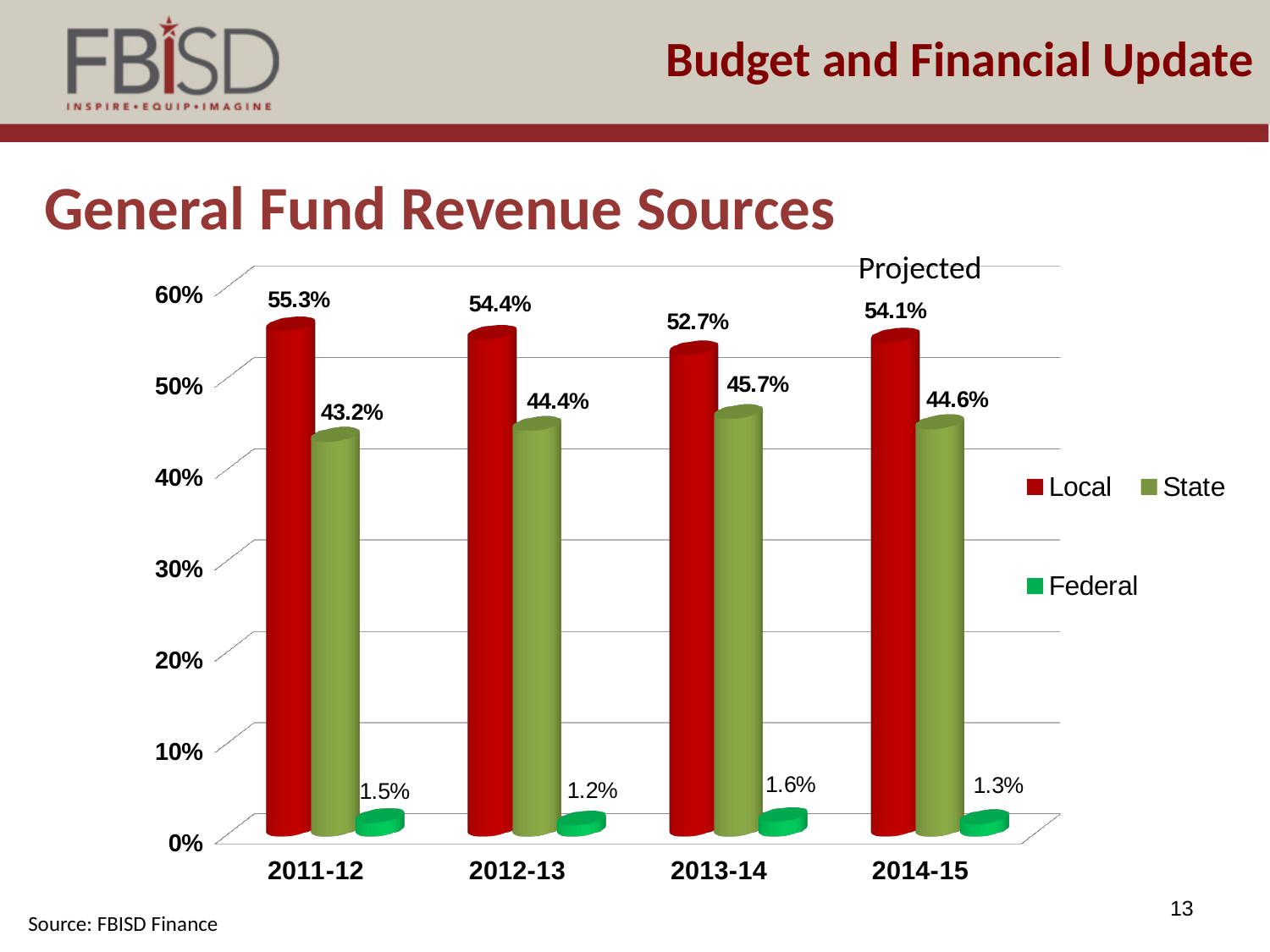
How many fiscal years are shown on the x axis? 4 Which is larger in 2014-15, the Local share or the State share? Local What is the Federal revenue share for 2012-13? 1.2% What is the Local revenue share for 2011-12? 55.3% What is the State revenue share for 2013-14? 45.7% How many series does the legend list? 3 What kind of chart is shown on the slide? Bar chart In which year is the Local revenue share the lowest? 2013-14 In which year is the State revenue share the highest? 2013-14 What is the title of the chart? General Fund Revenue Sources What is the projected Local revenue share for 2014-15? 54.1% What is the difference between the Local and State shares in 2012-13? 10.0%